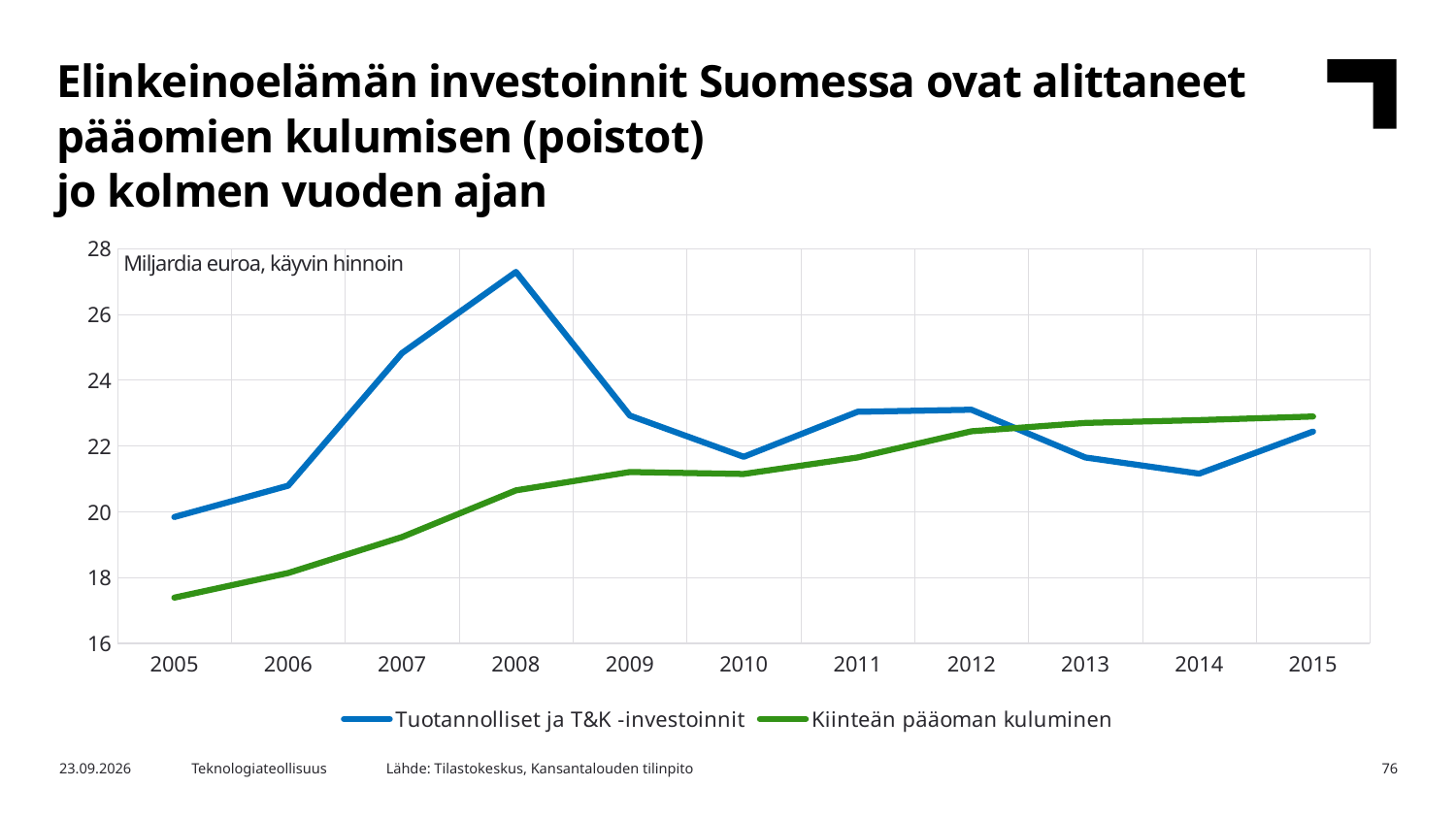
In 2014, which series has the larger value: Tuotannolliset ja T&K -investoinnit or Kiinteän pääoman kuluminen? Kiinteän pääoman kuluminen Is the value for Tuotannolliset ja T&K -investoinnit in 2008 greater or less than 26? greater In which year is the Tuotannolliset ja T&K -investoinnit series at its lowest value? 2005 Is the value for Kiinteän pääoman kuluminen in 2005 greater or less than 18? less What kind of chart is shown on the slide? Line chart In 2008, which series has the larger value: Tuotannolliset ja T&K -investoinnit or Kiinteän pääoman kuluminen? Tuotannolliset ja T&K -investoinnit What unit label is shown inside the chart area? Miljardia euroa, käyvin hinnoin Does the Kiinteän pääoman kuluminen series generally rise or fall from 2005 to 2015? Rise How many years are plotted along the x axis? 11 How many series does the legend list? 2 In which year does the Tuotannolliset ja T&K -investoinnit series reach its highest value? 2008 In which year is the Kiinteän pääoman kuluminen series at its lowest value? 2005